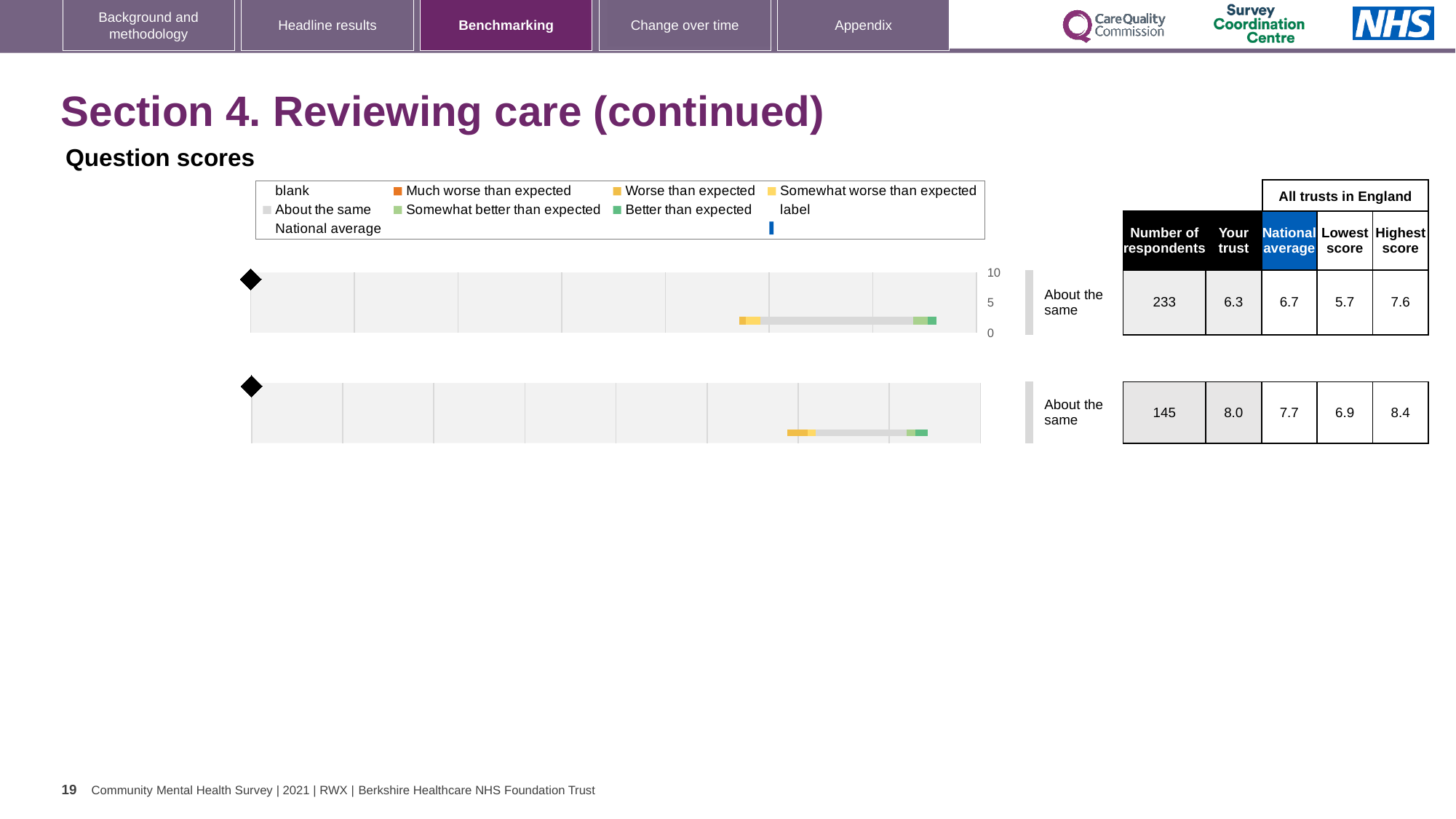
What kind of chart is used to show the question scores on this slide? bar chart What benchmark category label is shown next to the top chart? About the same For the bottom chart, what is the national average score shown in the table? 7.7 For the top chart, what is the number of respondents shown in the table? 233 For the bottom chart, what is the highest score among all trusts in England? 8.4 For the top chart, what is the 'Your trust' score shown in the table? 6.3 For the top chart, is the 'Your trust' score higher or lower than the national average? lower For the bottom chart, what is the difference between the highest score and the lowest score among all trusts in England? 1.5 For the bottom chart, is the 'Your trust' score higher or lower than the national average? higher How many charts are shown on the slide? 2 Which legend entry is shown with an orange marker? Much worse than expected For the top chart, what is the difference between the highest score and the lowest score among all trusts in England? 1.9